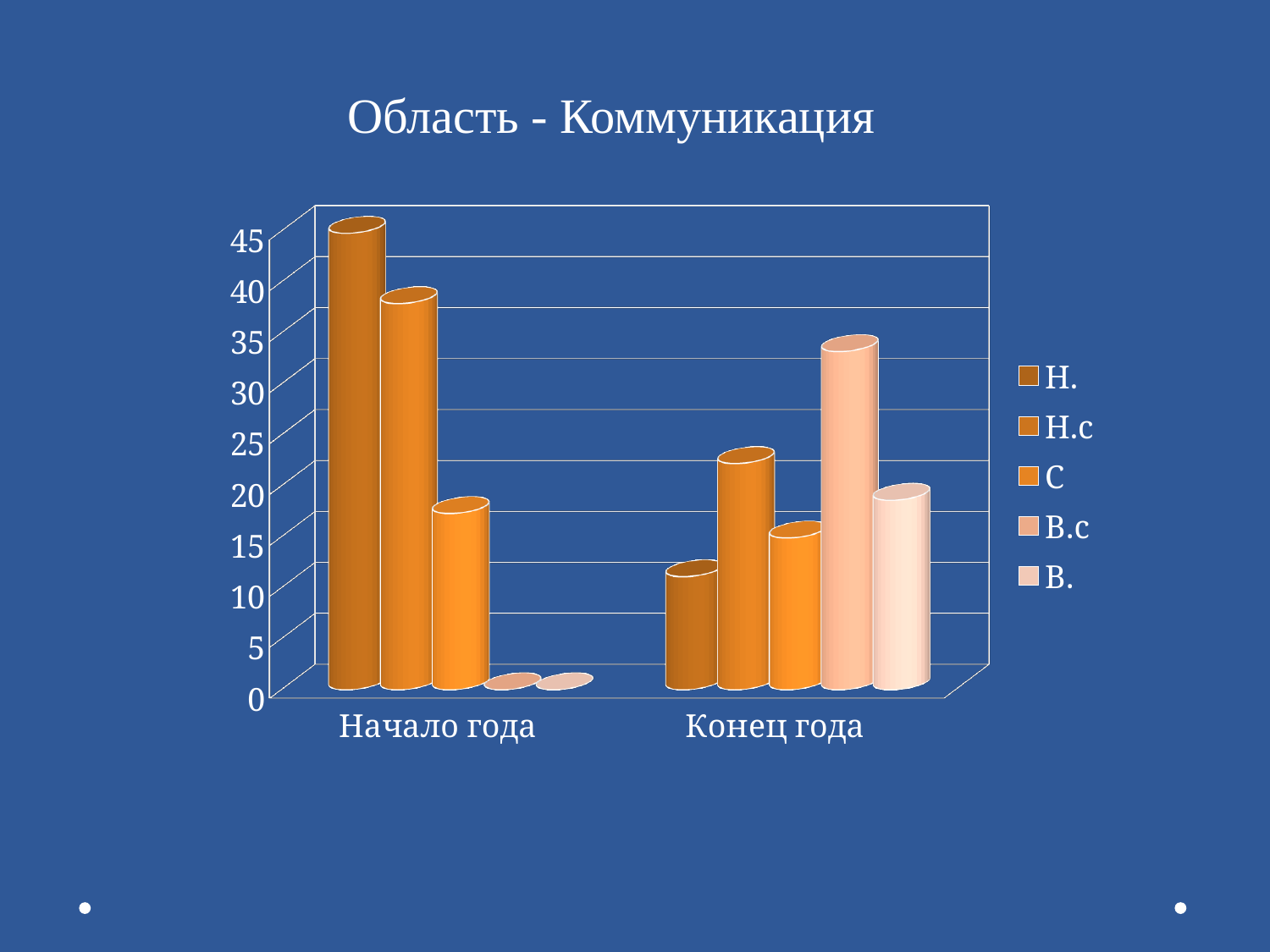
What kind of chart is shown on the slide? bar chart What is the title of the chart? Область - Коммуникация For the series Н., which is larger: Начало года or Конец года? Начало года Is the value for В.с at Конец года greater or less than 25? greater Is the value for С at Начало года greater or less than 25? less Is the value for Н. at Конец года greater or less than 20? less How many series does the legend list? 5 Which series has the highest value for Конец года? В.с Which series has the lowest value for Конец года? Н. Which series has the highest value for Начало года? Н. How many categories are shown on the x axis? 2